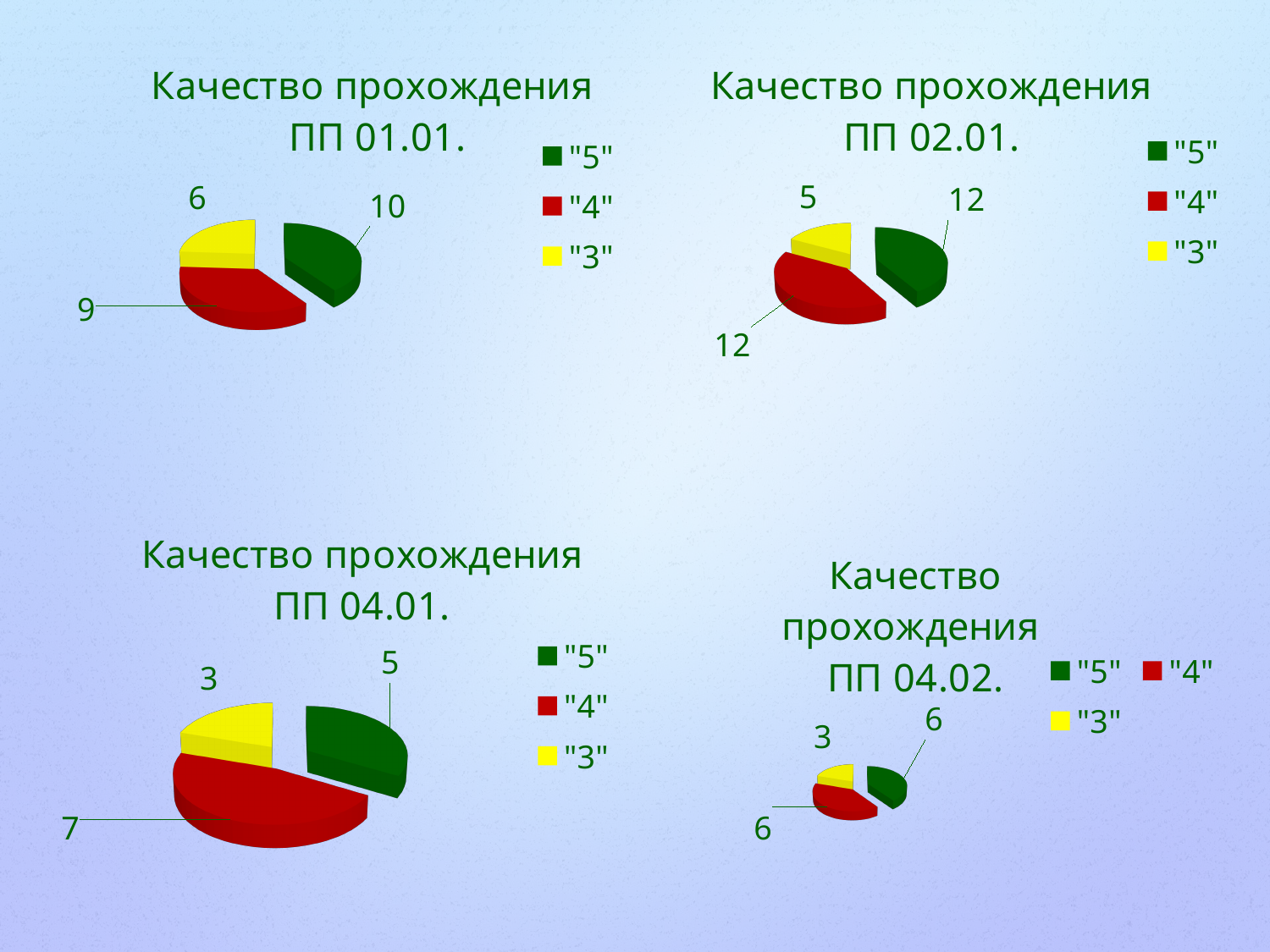
In the chart titled "Качество прохождения ПП 02.01.", what is the difference between the values for "5" and "3"? 7 In the chart titled "Качество прохождения ПП 04.01.", what share of the pie does "3" represent? 20% In the chart titled "Качество прохождения ПП 04.02.", what is the value for "3"? 3 In the chart titled "Качество прохождения ПП 01.01.", what is the value for "5"? 10 In the chart titled "Качество прохождения ПП 02.01.", what is the value for "3"? 5 In the chart titled "Качество прохождения ПП 04.02.", which is larger, the value for "5" or the value for "3"? "5" What kind of chart is the chart titled "Качество прохождения ПП 02.01."? Pie chart In the chart titled "Качество прохождения ПП 04.01.", which category has the highest value? "4" In the chart titled "Качество прохождения ПП 01.01.", what share of the pie does "5" represent? 40% How many categories does the legend of the chart titled "Качество прохождения ПП 04.01." list? 3 In the chart titled "Качество прохождения ПП 01.01.", which category has the lowest value? "3" In the chart titled "Качество прохождения ПП 04.01.", what is the value for "4"? 7